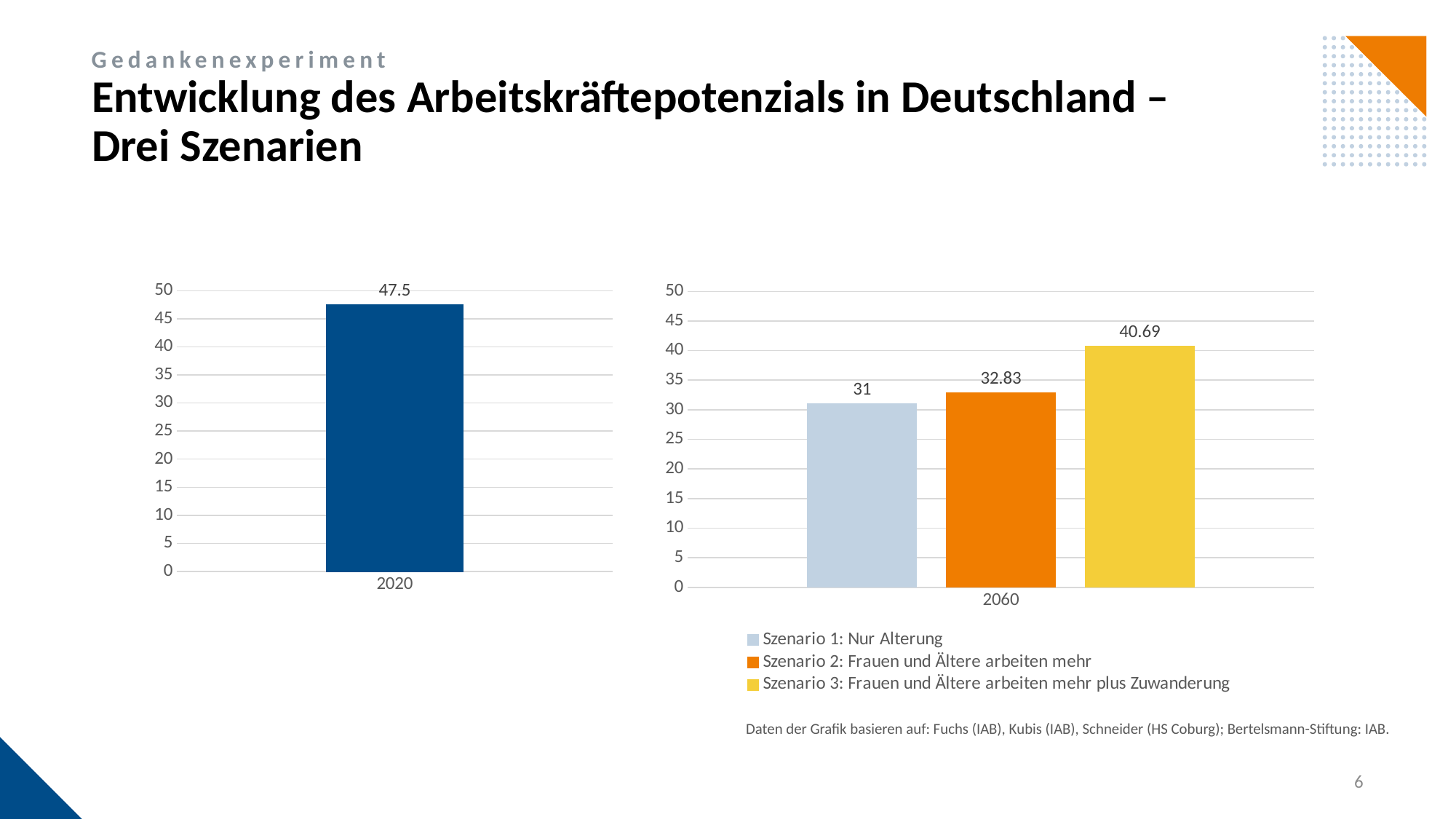
In the right chart, is the value for Szenario 3 greater or less than 40? greater In the right chart, what is the value for Szenario 2: Frauen und Ältere arbeiten mehr? 32.83 In the right chart, what is the value for Szenario 3: Frauen und Ältere arbeiten mehr plus Zuwanderung? 40.69 How many series does the legend of the right chart list? 3 In the left chart, what is the value for 2020? 47.5 In the right chart, what is the difference between Szenario 3 and Szenario 1? 9.69 In the right chart, which scenario has the lowest value? Szenario 1: Nur Alterung What kind of chart is the left chart? Bar chart What is the difference between the 2020 value in the left chart and the Szenario 3 value in the right chart? 6.81 In the right chart, which scenario has the highest value? Szenario 3: Frauen und Ältere arbeiten mehr plus Zuwanderung In the right chart, what is the value for Szenario 1: Nur Alterung in 2060? 31 In the right chart, which is larger: Szenario 2 or Szenario 1? Szenario 2